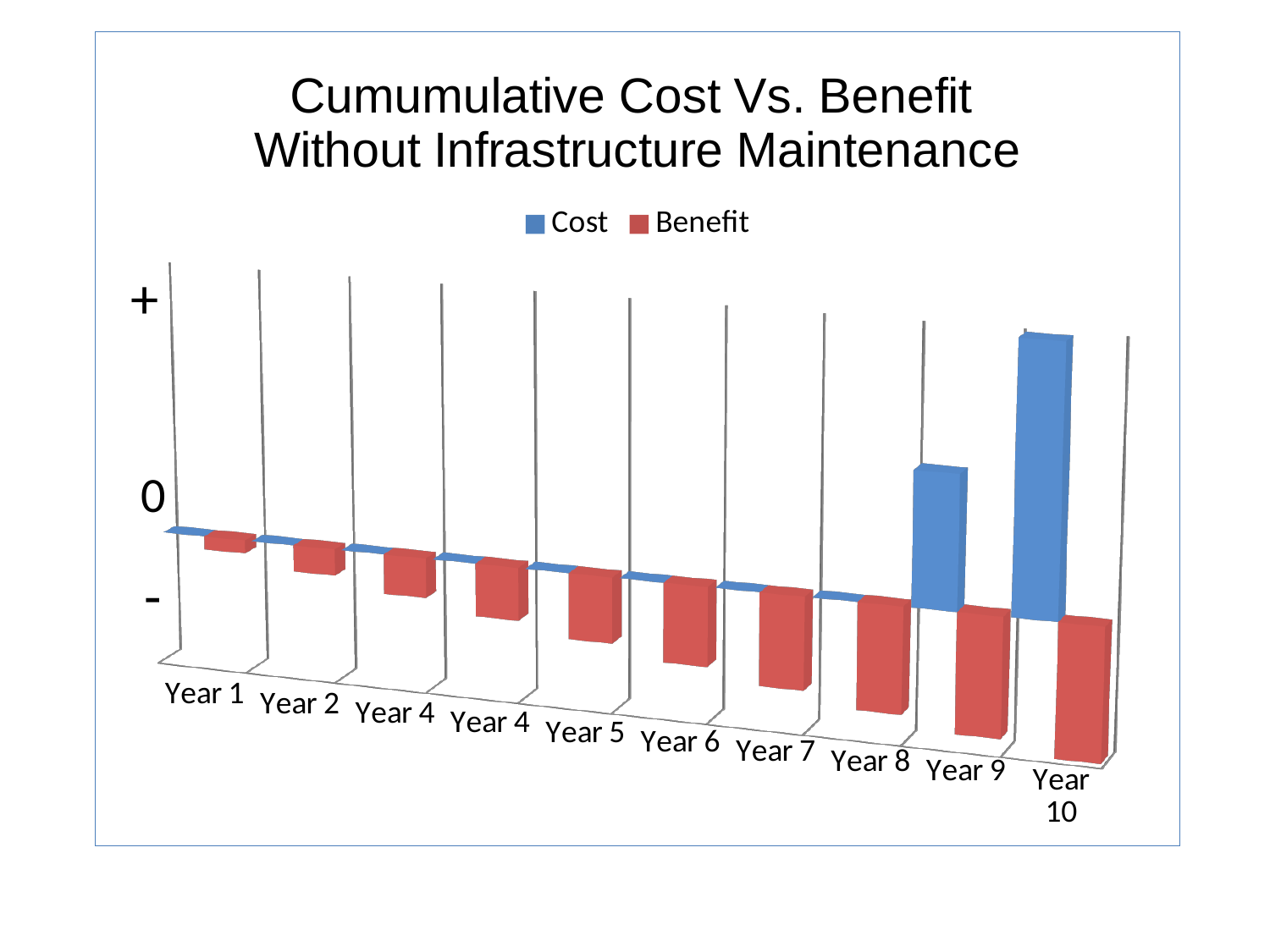
Is the Cost value for Year 10 greater or less than 0? greater Which is larger, the Cost value for Year 9 or the Cost value for Year 10? Year 10 Which two series are listed in the legend? Cost and Benefit In which year is the Cost bar highest? Year 10 Which is larger, the Benefit value for Year 1 or the Benefit value for Year 8? Year 1 How many year categories are shown along the x axis? 10 Is the Benefit value for Year 5 greater or less than 0? less What is the title of the chart? Cumumulative Cost Vs. Benefit Without Infrastructure Maintenance Do the Benefit bars become more negative or less negative from Year 1 to Year 10? More negative In which year is the Benefit bar lowest (most negative)? Year 10 What kind of chart is shown on the slide? Bar chart How many series does the legend list? 2